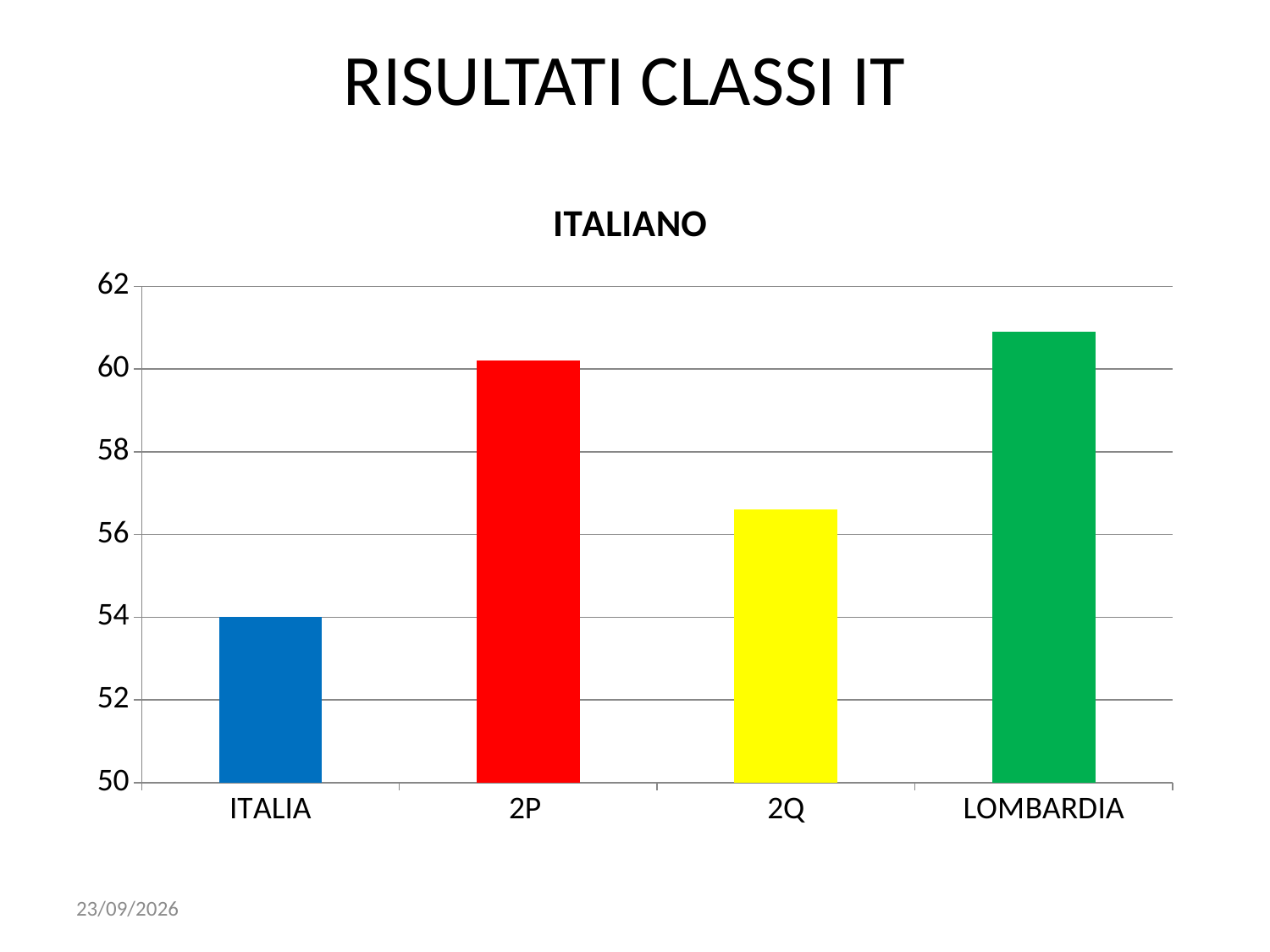
How many categories are shown on the x axis? 4 What kind of chart is shown on the slide? bar chart What is the value for ITALIA? 54 Which category has the lowest value? ITALIA Is the value for 2P greater or less than 60? greater Is the value for LOMBARDIA greater or less than 62? less Is the value for 2Q greater or less than 58? less Which is larger, the value for ITALIA or the value for 2Q? 2Q Which is larger, the value for 2P or the value for 2Q? 2P What is the title of the chart? ITALIANO Which category has the highest value? LOMBARDIA